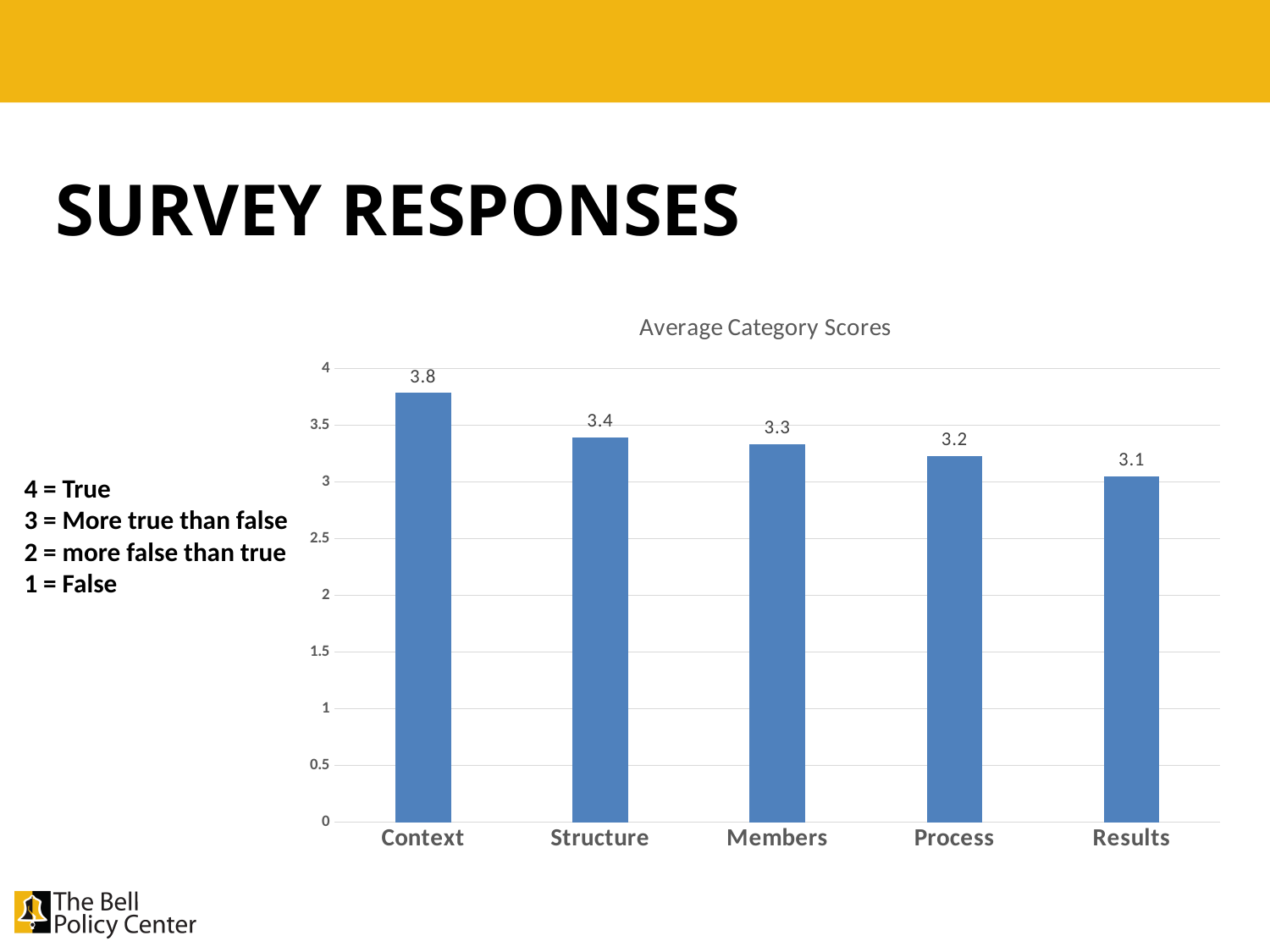
What is the average category score for Members? 3.3 What is the average category score for Process? 3.2 What is the average category score for Structure? 3.4 How many categories are shown in the chart? 5 Do the scores rise or fall from Context to Results along the x axis? Fall Which has a higher average score, Structure or Process? Structure Which category has the highest average score? Context What is the difference between the Context score and the Results score? 0.7 What kind of chart is shown on the slide? Bar chart Which category has the lowest average score? Results What is the average category score for Results? 3.1 What is the average category score for Context? 3.8